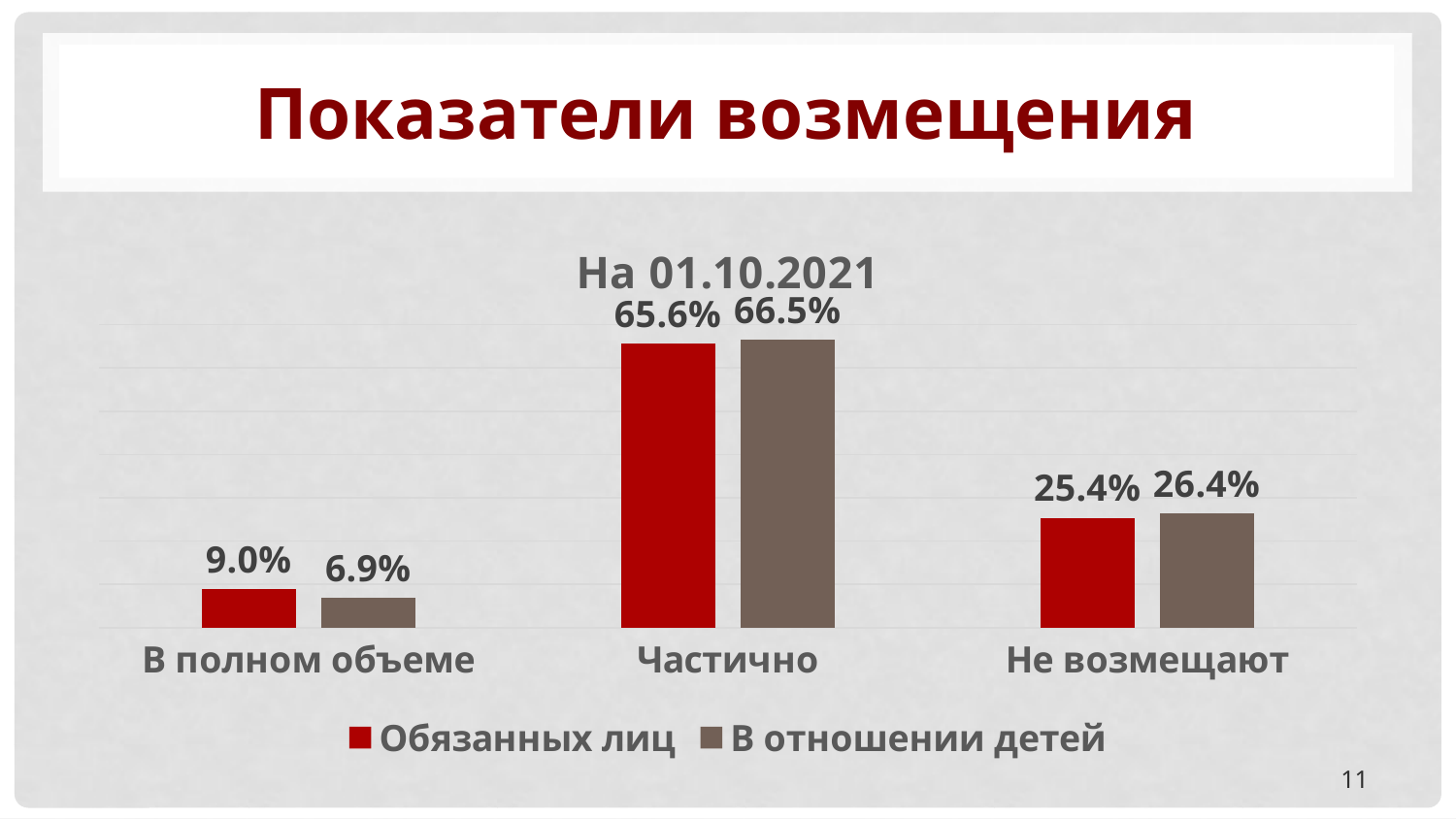
What is the value for "Обязанных лиц" in the "Частично" category? 65.6% What is the difference between the "Обязанных лиц" and "В отношении детей" values in the "В полном объеме" category? 2.1% What is the value for "В отношении детей" in the "В полном объеме" category? 6.9% What kind of chart is shown on the slide? Bar chart Which category has the highest value for the "Обязанных лиц" series? Частично Which category has the lowest value for the "В отношении детей" series? В полном объеме What is the title of the chart? На 01.10.2021 In the "Не возмещают" category, which series has the larger value, "Обязанных лиц" or "В отношении детей"? В отношении детей What is the value for "В отношении детей" in the "Не возмещают" category? 26.4% How many series does the legend list? 2 What colour are the bars for the "Обязанных лиц" series? Red How many categories are shown on the x axis? 3